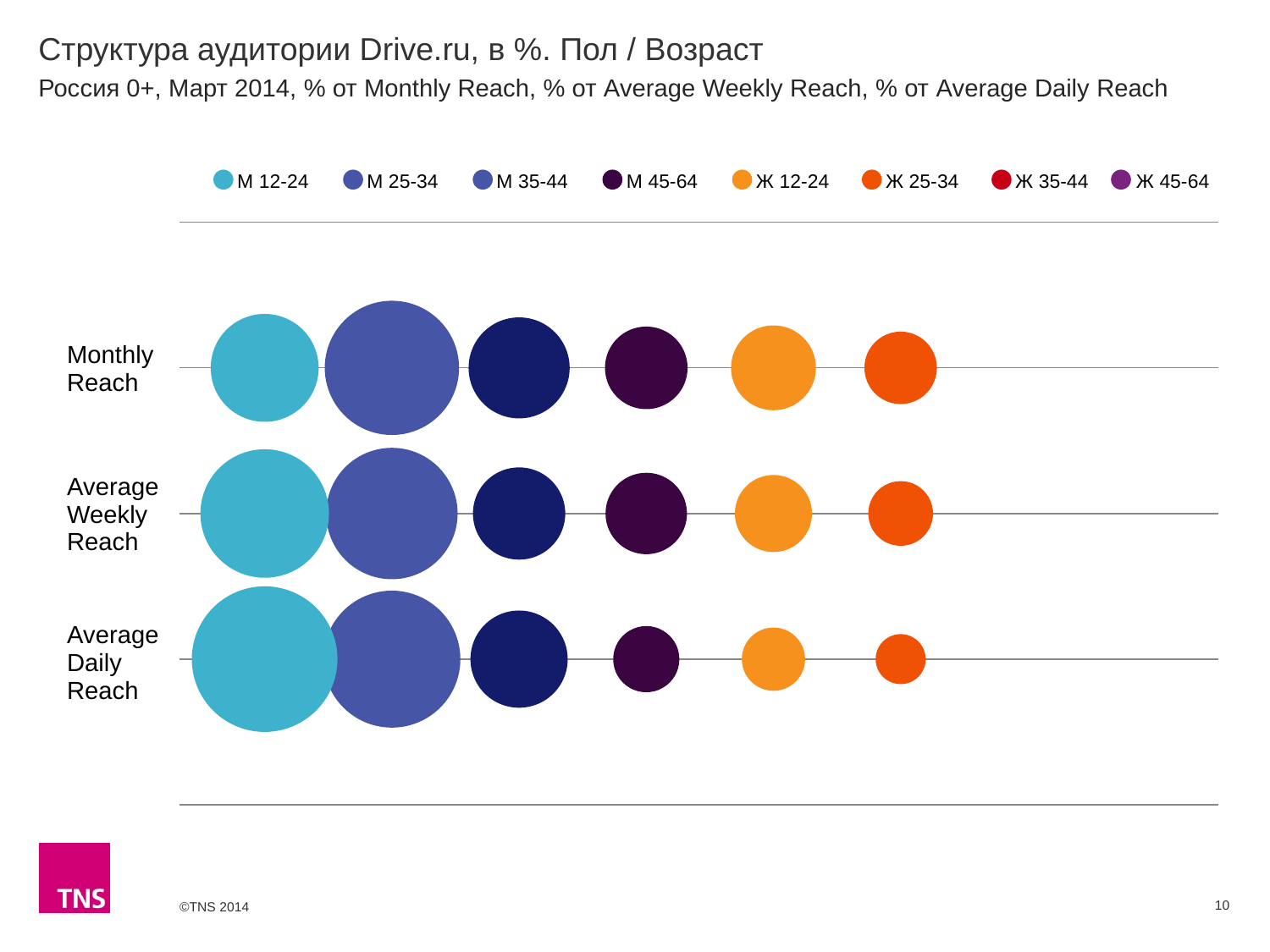
In the Monthly Reach row, which bubble is larger: М 25-34 or Ж 25-34? М 25-34 In the Average Daily Reach row, which bubble is larger: М 12-24 or М 45-64? М 12-24 How many reach categories (rows) are plotted on the chart? 3 In the Monthly Reach row, which visible group has the smallest bubble? Ж 25-34 What kind of chart is shown on the slide? Bubble chart Is the М 12-24 bubble larger in the Monthly Reach row or in the Average Daily Reach row? Average Daily Reach In the Average Daily Reach row, which visible group has the smallest bubble? Ж 25-34 How many series does the legend list? 8 What are the three row labels on the chart? Monthly Reach, Average Weekly Reach, Average Daily Reach In the Monthly Reach row, which group has the largest bubble? М 25-34 Which legend entry is shown in light blue? М 12-24